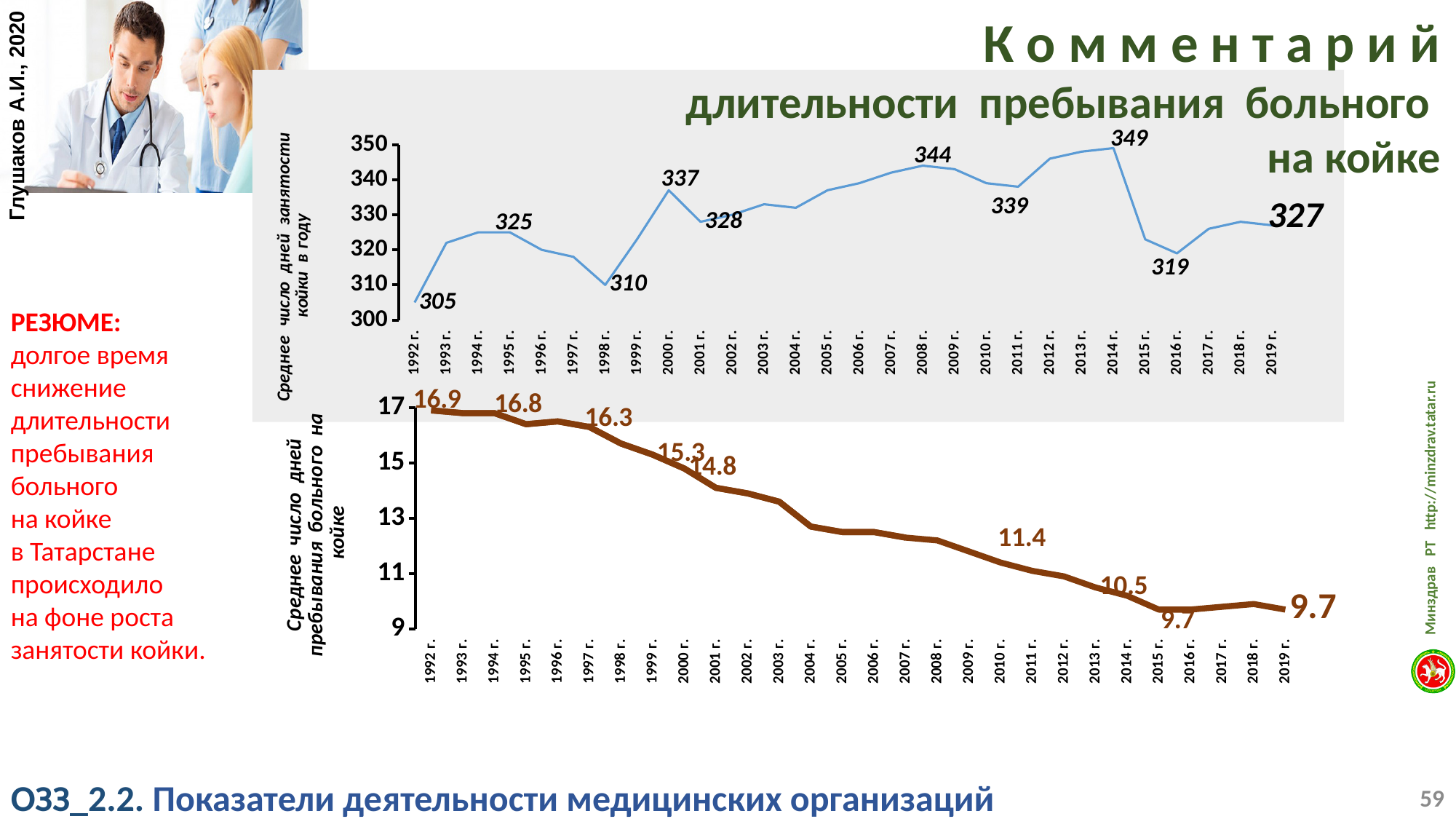
In the top chart (average number of bed occupancy days per year), what is the value for 2014? 349 In the bottom chart (average length of patient stay), what is the value for 2019? 9.7 In the bottom chart (average length of patient stay), what is the value for 1992? 16.9 What type of chart is used for the bottom chart (average length of patient stay)? line chart In the top chart (average number of bed occupancy days per year), which year has the highest value? 2014 In the bottom chart, by how much did the average length of stay fall from 1992 to 2019? 7.2 In the top chart (average number of bed occupancy days per year), what is the value for 1992? 305 In the top chart, which is larger: the value for 2000 or the value for 2001? 2000 In the bottom chart (average length of patient stay), do the values rise or fall over the years? fall In the top chart (average number of bed occupancy days per year), which year has the lowest value? 1992 In the top chart (average number of bed occupancy days per year), what is the value for 2019? 327 In the top chart, what is the difference between the 2014 value and the 1992 value? 44